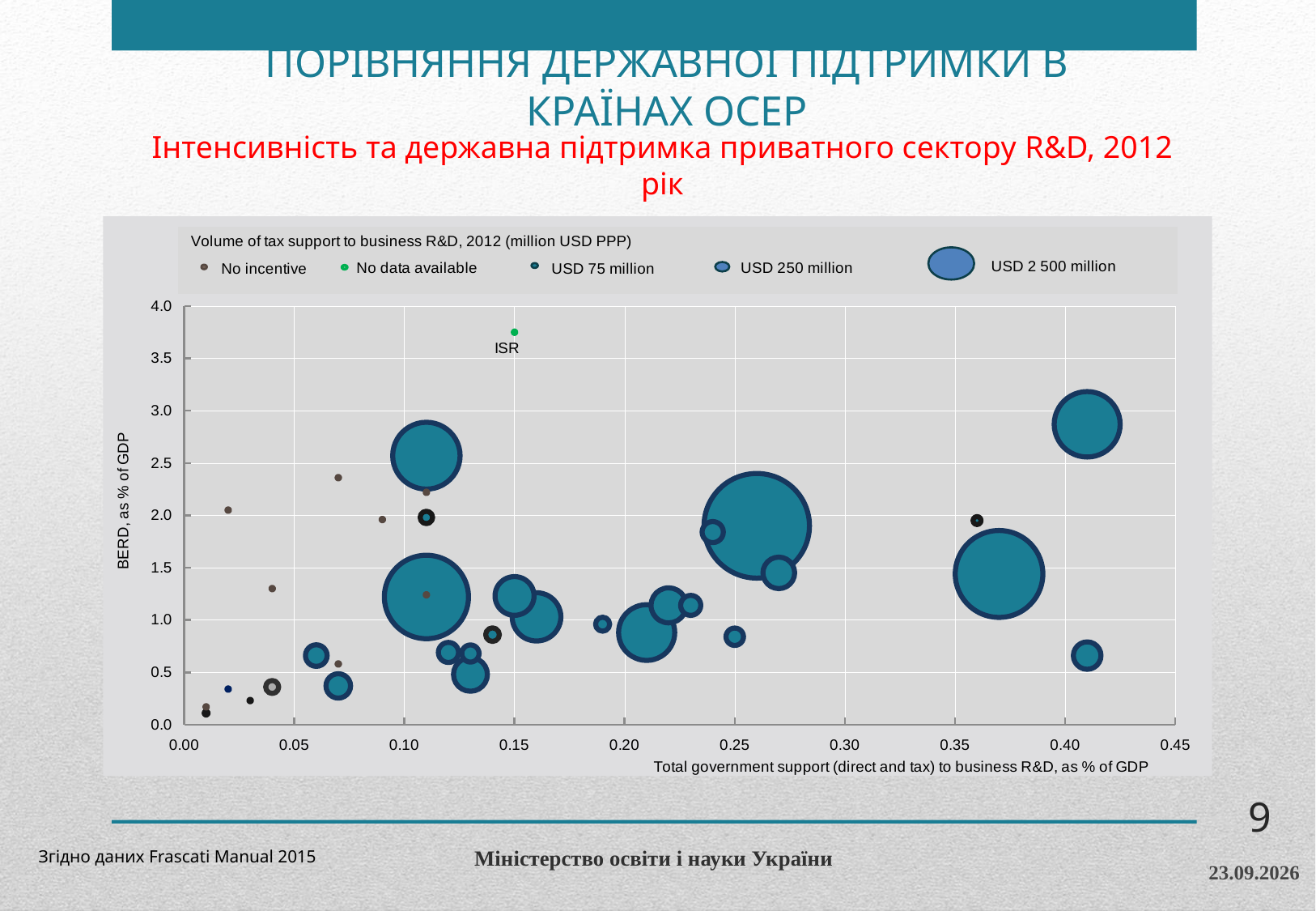
Is the BERD as % of GDP value for ISR greater or less than 3.5? greater Is the BERD as % of GDP value for ISR greater or less than 4.0? less What is the maximum value shown on the vertical axis? 4.0 How many entries does the chart legend list? 5 What is the maximum value shown on the horizontal axis? 0.45 Is the total government support value for ISR greater or less than 0.10? greater According to the legend, what does a green point indicate? No data available Which labelled point has the highest BERD as % of GDP? ISR What kind of chart is shown on the slide? bubble chart What is the label of the vertical axis? BERD, as % of GDP